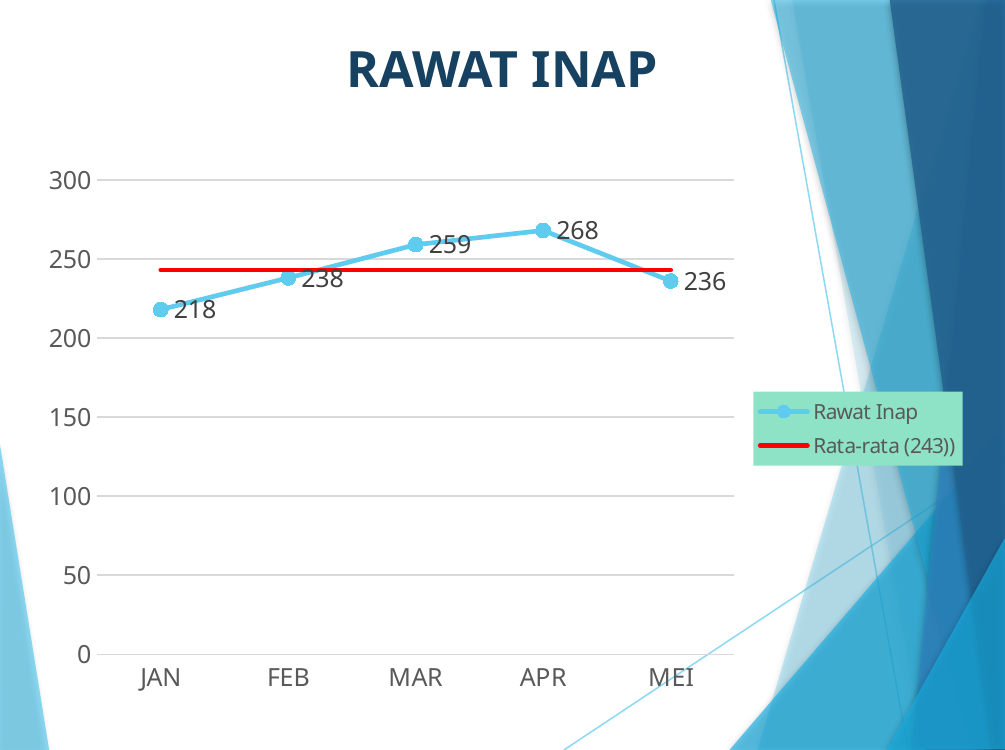
How many months are plotted on the x axis? 5 What is the Rawat Inap value for MEI? 236 Which month has the highest Rawat Inap value? APR What is the title of the chart? RAWAT INAP Is the Rawat Inap value for JAN greater or less than 250? less What is the Rawat Inap value for APR? 268 Which month has the lowest Rawat Inap value? JAN What is the Rawat Inap value for JAN? 218 What is the difference between the Rawat Inap values for APR and JAN? 50 Which is larger, the Rawat Inap value for MAR or for FEB? MAR How many series does the legend list? 2 What kind of chart is shown? line chart